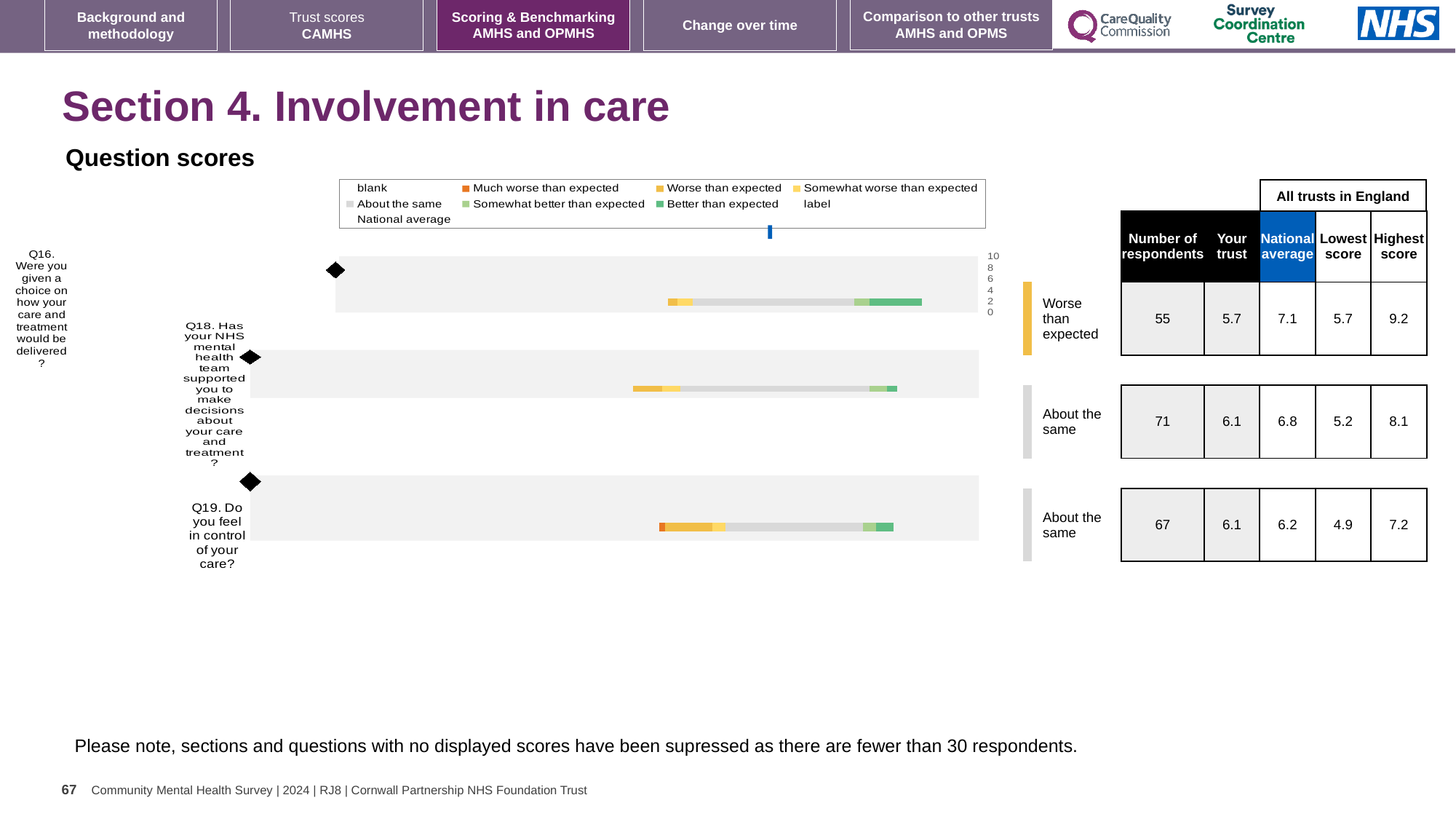
For Q19, which is larger: the 'Your trust' score or the national average? National average Which question has the lowest 'Your trust' score? Q16 Which question has the highest number of respondents? Q18 How many respondents answered Q19 (Do you feel in control of your care?)? 67 What is the highest score among all trusts in England for Q16? 9.2 What kind of chart is used to show the question scores on this slide? bar chart What is the difference between the national average and the 'Your trust' score for Q16? 1.4 What is the lowest score among all trusts in England for Q19? 4.9 What benchmark category is shown next to Q16's bar? Worse than expected What is the 'Your trust' score for Q16 (Were you given a choice on how your care and treatment would be delivered?)? 5.7 How many questions are plotted in the question scores chart? 3 What is the national average score for Q18 (Has your NHS mental health team supported you to make decisions about your care and treatment?)? 6.8